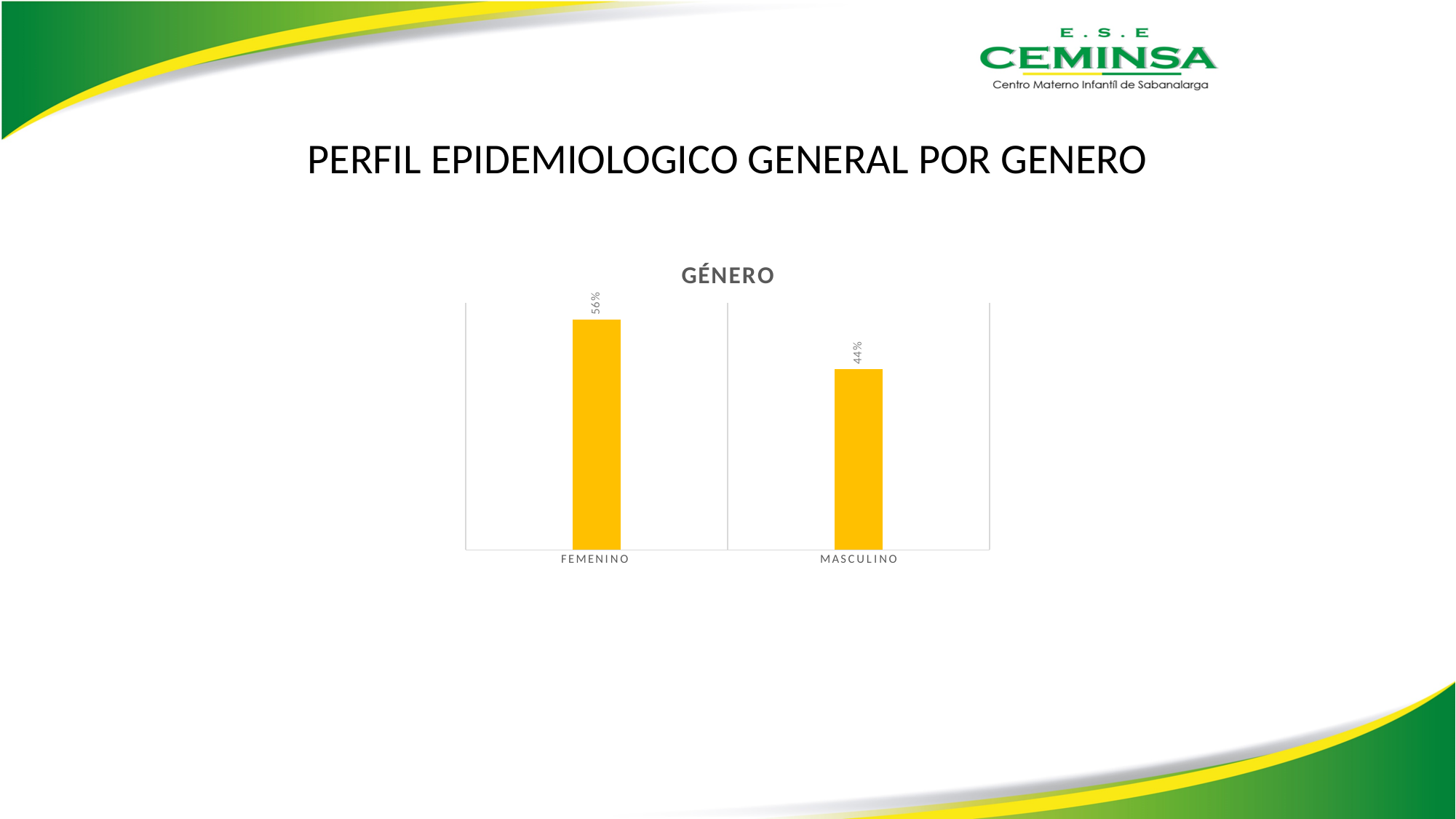
What is the total of the values for FEMENINO and MASCULINO? 100% Which category has the lowest value? MASCULINO What is the value for MASCULINO? 44% What is the value for FEMENINO? 56% Which category has the highest value? FEMENINO What is the title of the chart? GÉNERO Which is larger, the value for FEMENINO or the value for MASCULINO? FEMENINO What kind of chart is shown on the slide? Bar chart What is the difference between the values for FEMENINO and MASCULINO? 12% What colour are the bars in the chart? Yellow How many categories are shown in the chart? 2